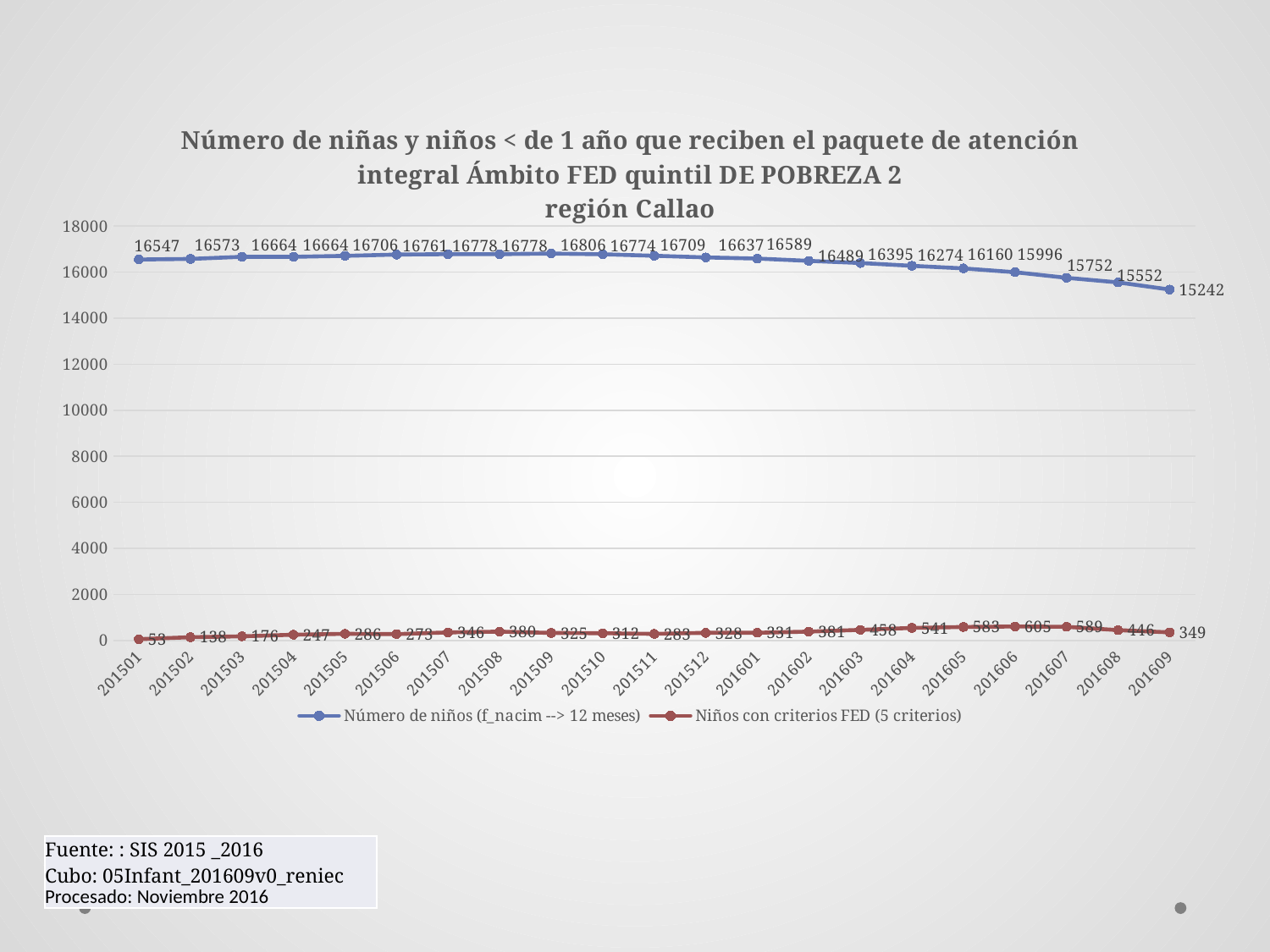
How many series does the legend list? 2 In which period does 'Número de niños (f_nacim --> 12 meses)' reach its highest value? 201509 What is the value of 'Número de niños (f_nacim --> 12 meses)' for 201501? 16547 How many time periods are plotted along the x axis? 21 Does 'Número de niños (f_nacim --> 12 meses)' rise or fall between 201601 and 201609? fall Which region is named in the chart title? Callao What is the difference between the 'Número de niños (f_nacim --> 12 meses)' values for 201501 and 201609? 1305 What is the value of 'Niños con criterios FED (5 criterios)' for 201606? 605 What is the value of 'Número de niños (f_nacim --> 12 meses)' for 201609? 15242 In which period is 'Niños con criterios FED (5 criterios)' lowest? 201501 Which is larger: 'Niños con criterios FED (5 criterios)' for 201605 or for 201608? 201605 What type of chart is shown on the slide? line chart